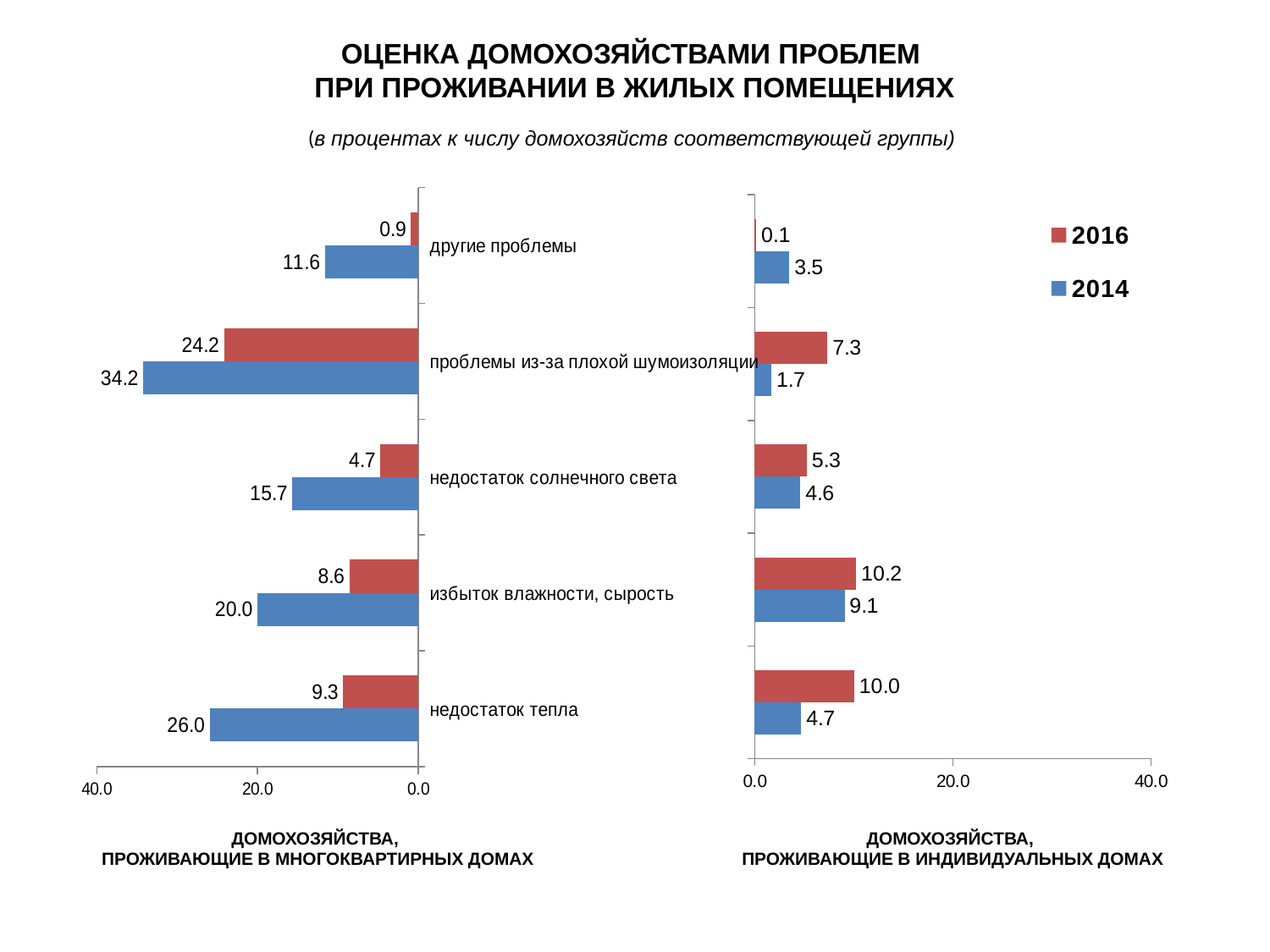
On the right chart (households living in individual houses), what is the 2016 value for 'избыток влажности, сырость'? 10.2 What type of chart is used on the slide? bar chart On the left chart (households living in apartment buildings), which category has the highest 2016 value? проблемы из-за плохой шумоизоляции On the right chart (households living in individual houses), which is larger for 'недостаток тепла': the 2016 value or the 2014 value? 2016 How many series does the legend list? 2 On the left chart (households living in apartment buildings), what is the difference between the 2014 and 2016 values for 'недостаток тепла'? 16.7 On the right chart (households living in individual houses), which category has the lowest 2016 value? другие проблемы On the left chart (households living in apartment buildings), is the 2014 value for 'избыток влажности, сырость' greater or less than 40.0? less On the right chart (households living in individual houses), what is the difference between the 2016 and 2014 values for 'проблемы из-за плохой шумоизоляции'? 5.6 On the left chart (households living in apartment buildings), what is the 2016 value for 'недостаток тепла'? 9.3 On the left chart (households living in apartment buildings), what is the 2014 value for 'проблемы из-за плохой шумоизоляции'? 34.2 How many categories are shown on the left chart (households living in apartment buildings)? 5